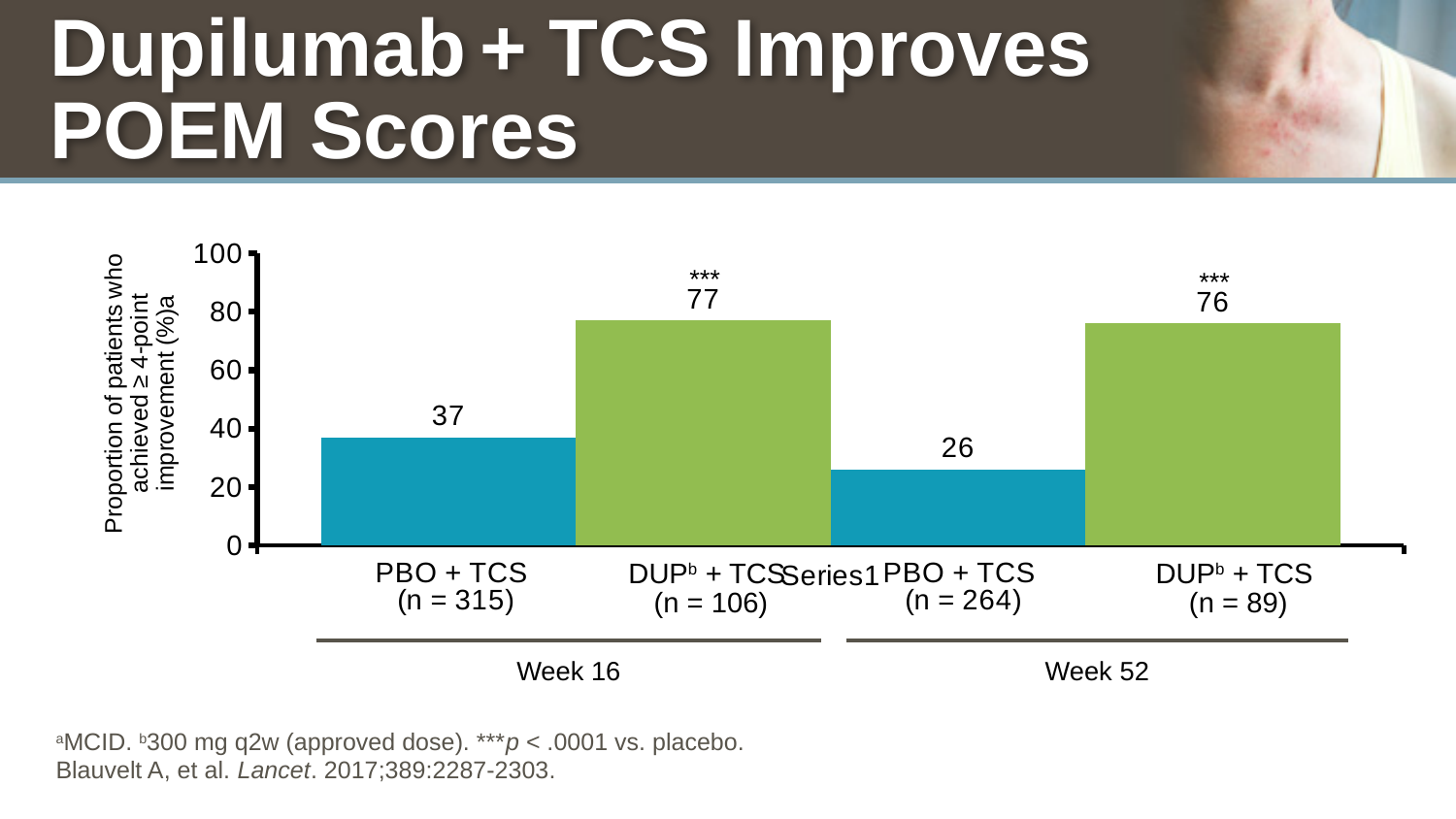
What is the difference between DUP + TCS and PBO + TCS at Week 16? 40 What is the value for DUP + TCS (n = 89) at Week 52? 76 What is the maximum value shown on the y axis? 100 How many bars are plotted in the chart? 4 What is the value for DUP + TCS (n = 106) at Week 16? 77 Which bar has the highest value? DUP + TCS (n = 106) at Week 16 Which is larger at Week 52: PBO + TCS or DUP + TCS? DUP + TCS What is the value for PBO + TCS (n = 315) at Week 16? 37 What is the value for PBO + TCS (n = 264) at Week 52? 26 What kind of chart is shown on the slide? Bar chart Which bar has the lowest value? PBO + TCS (n = 264) at Week 52 What is the difference between DUP + TCS and PBO + TCS at Week 52? 50